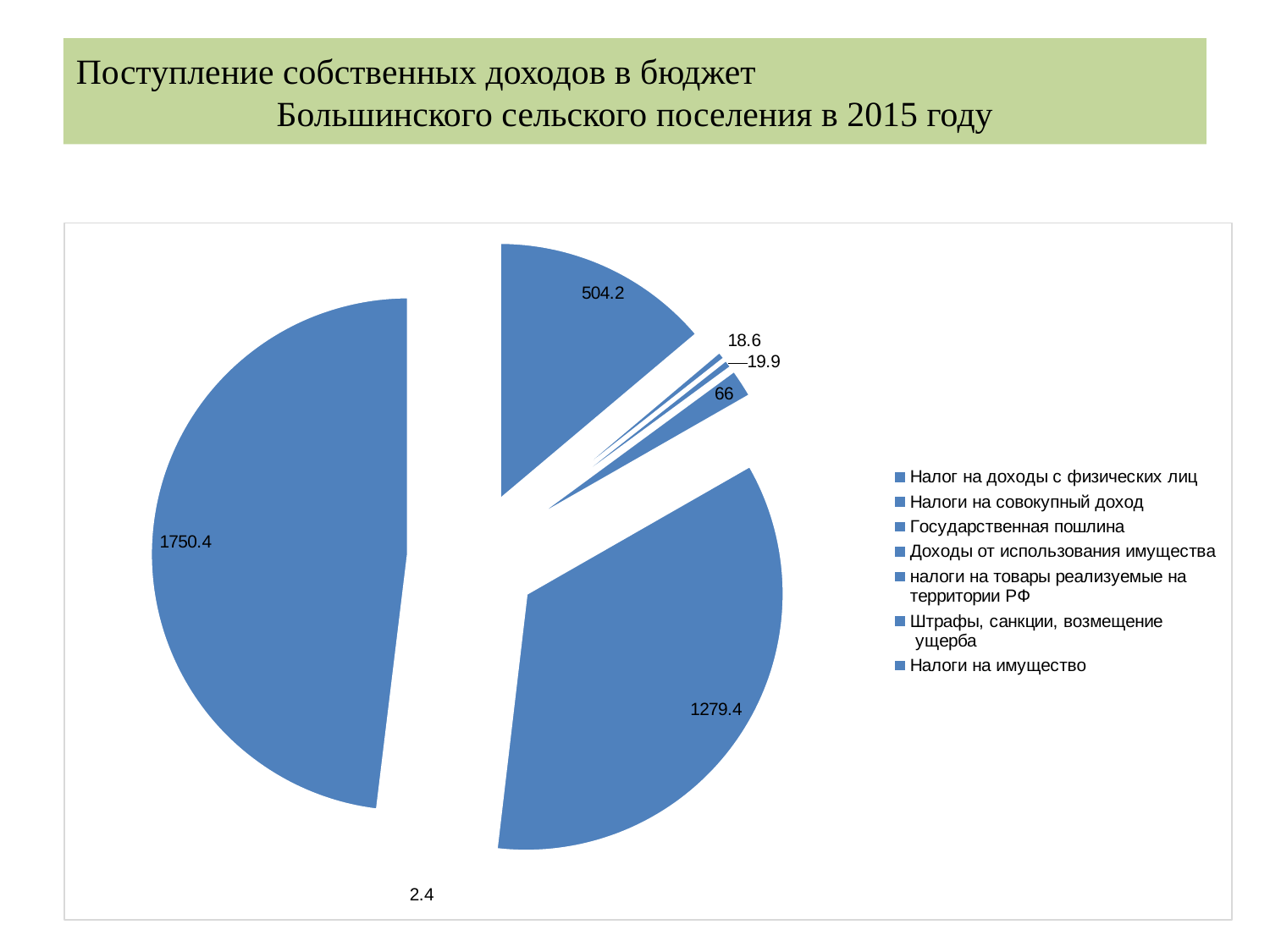
What is the first entry listed in the legend of the pie chart? Налог на доходы с физических лиц What type of chart is shown on the slide? pie chart What is the title of the slide containing the pie chart? Поступление собственных доходов в бюджет Большинского сельского поселения в 2015 году Which is larger, the slice labelled 66 or the slice labelled 19.9? 66 How many entries does the legend of the pie chart list? 7 How many slices does the pie chart have? 7 What is the largest value labelled on the pie chart? 1750.4 What is the total of all the values labelled on the pie chart? 3640.9 What is the difference between the slices labelled 1279.4 and 504.2? 775.2 What is the smallest value labelled on the pie chart? 2.4 Which is larger, the slice labelled 18.6 or the slice labelled 19.9? 19.9 What is the difference between the two largest labelled values on the pie chart, 1750.4 and 1279.4? 471